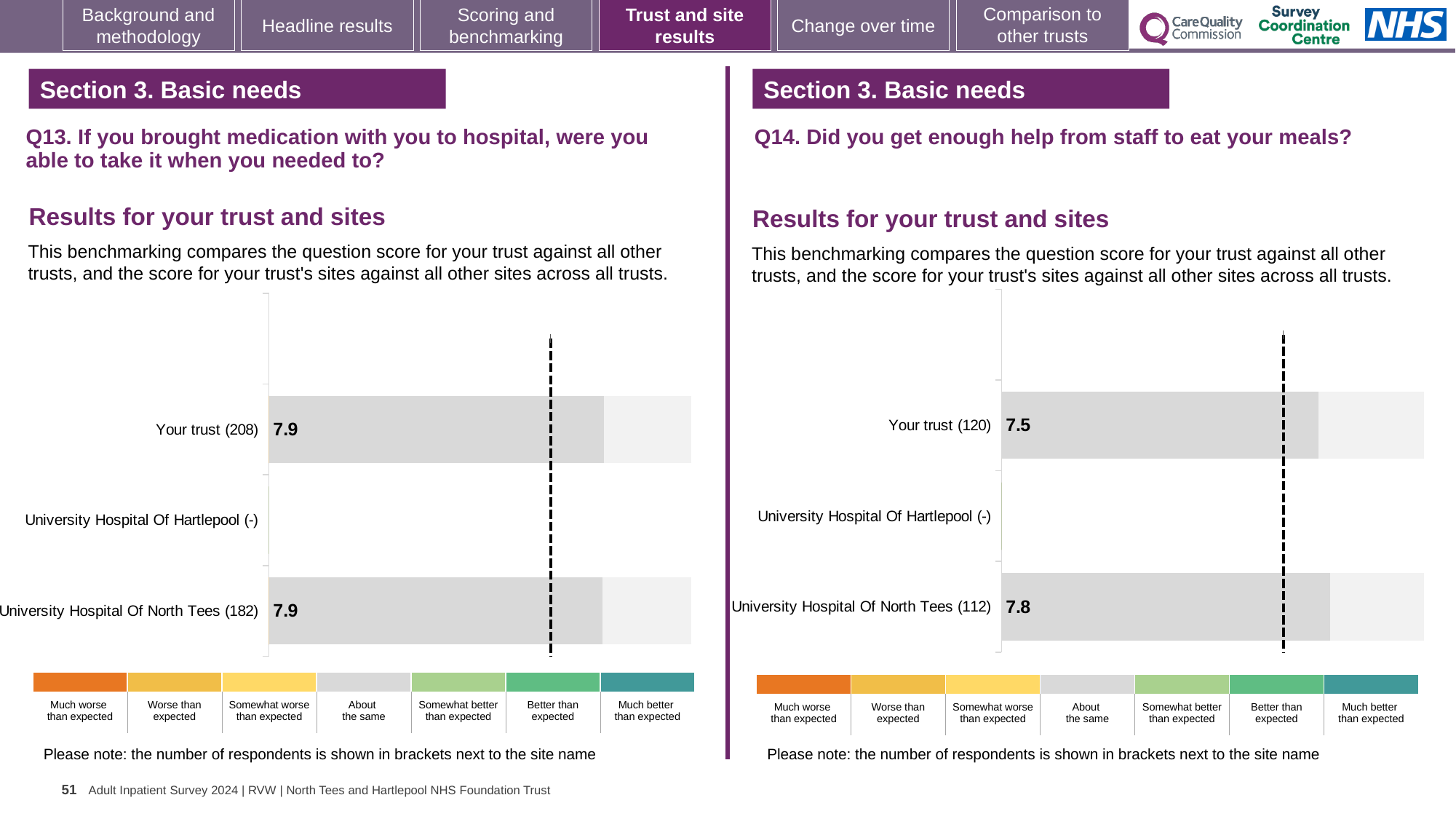
On the Q13 chart (left), what is the score for University Hospital Of North Tees (182)? 7.9 On the Q14 chart (right), which has the higher score: Your trust (120) or University Hospital Of North Tees (112)? University Hospital Of North Tees (112) On the Q14 chart (right), what is the score for Your trust (120)? 7.5 On the Q13 chart (left), which category has no bar plotted? University Hospital Of Hartlepool (-) What kind of chart is used on the Q14 chart (right)? Bar chart How many benchmark categories are shown in the colour legend below the Q14 chart (right)? 7 On the Q13 chart (left), what is the score for Your trust (208)? 7.9 On the Q14 chart (right), what is the score for University Hospital Of North Tees (112)? 7.8 On the Q14 chart (right), which category has the lowest printed score? Your trust (120) On the Q13 chart (left), how many categories are listed on the vertical axis? 3 On the Q13 chart (left), how many respondents are shown in brackets for University Hospital Of North Tees? 182 On the Q14 chart (right), what is the difference between the score for University Hospital Of North Tees (112) and the score for Your trust (120)? 0.3